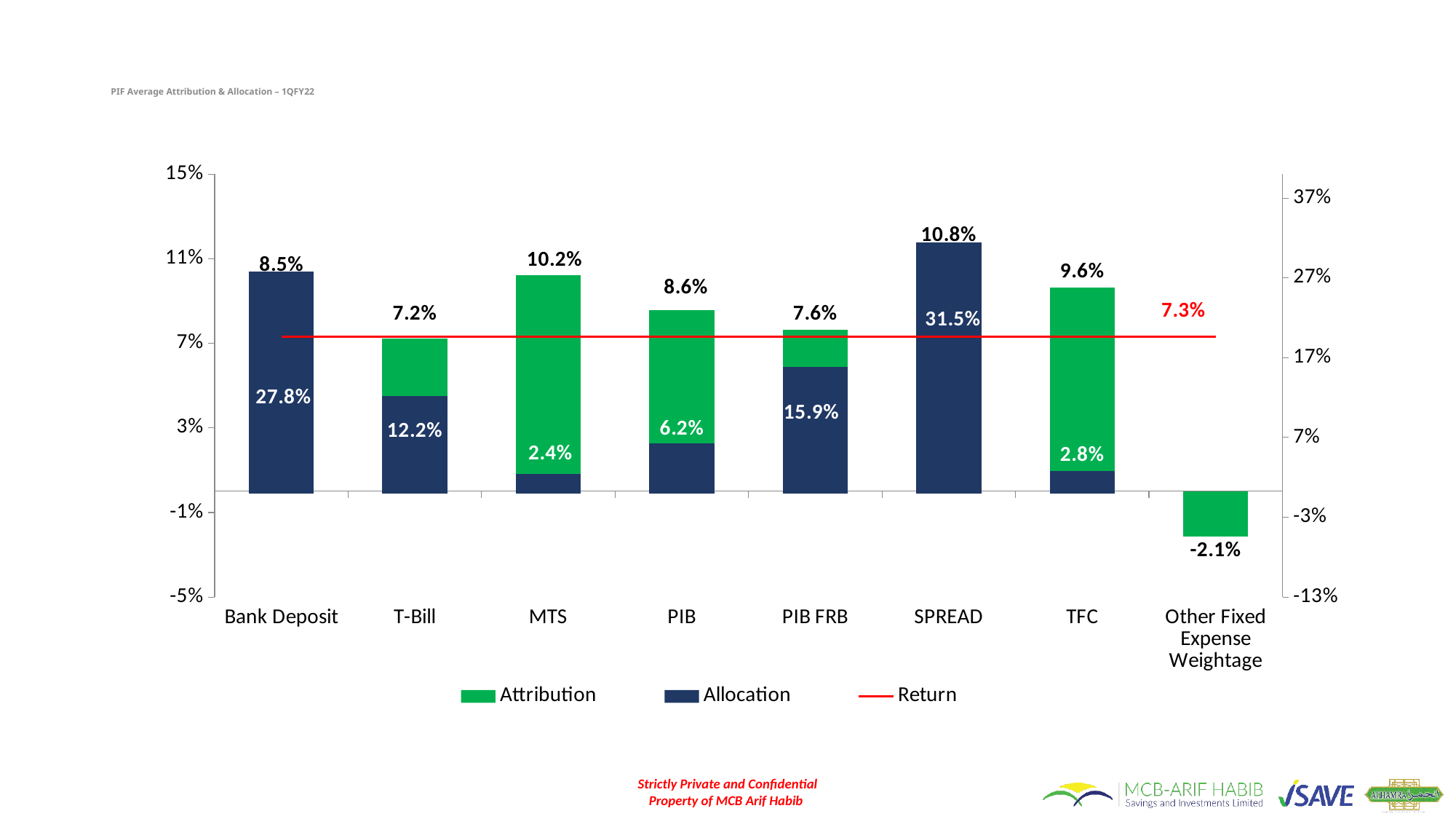
Which category has the highest attribution value? SPREAD Which has the larger attribution value, MTS or PIB? MTS What is the attribution value labelled for Bank Deposit? 8.5% What is the title of the chart? PIF Average Attribution & Allocation – 1QFY22 How many categories are shown on the x axis? 8 What type of chart is shown on the slide? Bar chart with a line Which category has the lowest allocation value? MTS What is the attribution value labelled for Other Fixed Expense Weightage? -2.1% How many series does the legend list? 3 What value is labelled on the Return line? 7.3% What is the allocation value labelled for SPREAD? 31.5% What is the difference between the attribution values of SPREAD and TFC? 1.2%